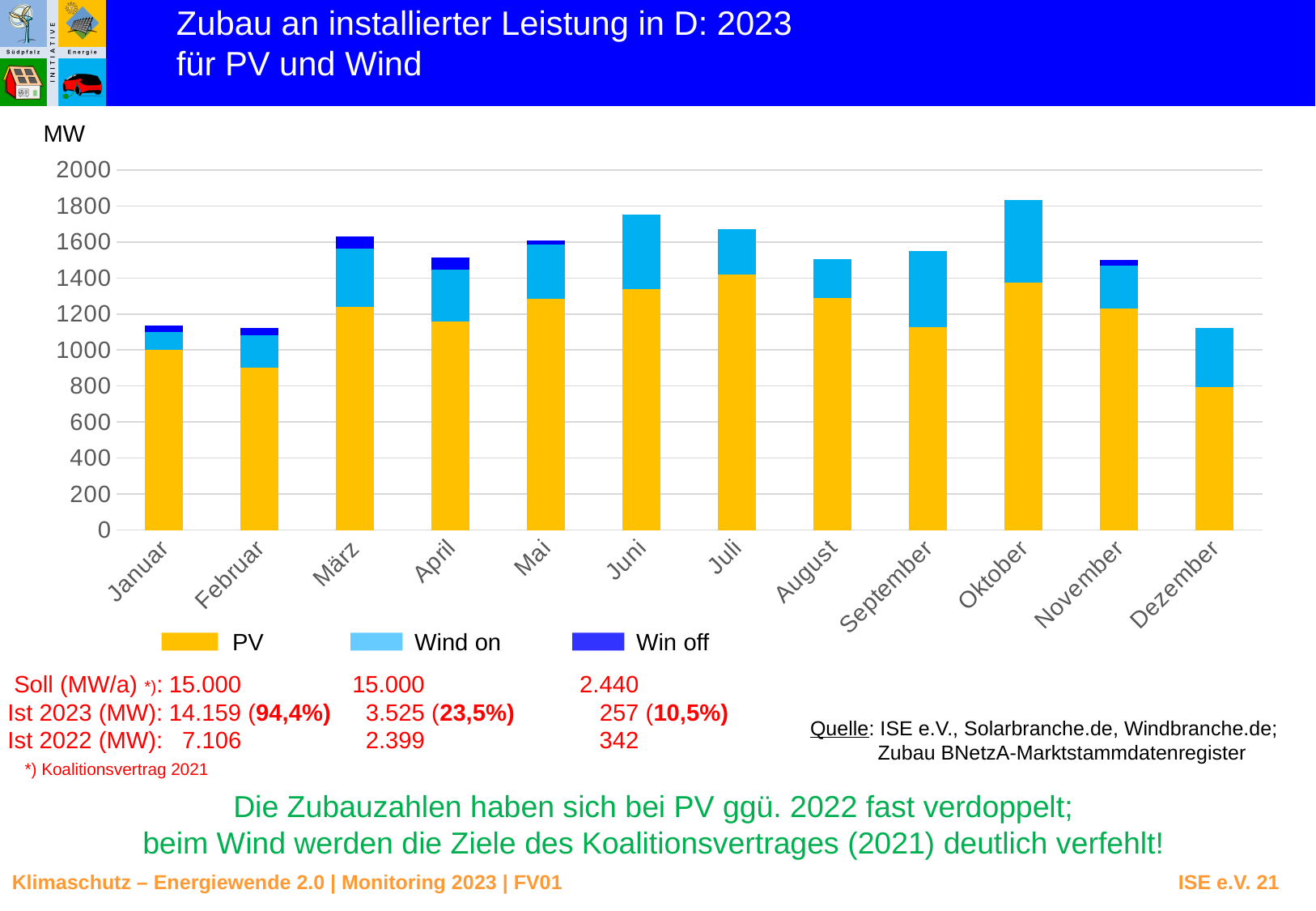
Is the total value for Juni greater or less than 1600? greater How many months (categories) are shown on the x axis of the chart? 12 What kind of chart is shown on the slide? stacked bar chart What are the three series names listed in the chart legend? PV, Wind on, Win off Is the PV value for Dezember greater or less than 1000? less How many series does the chart legend list? 3 Which month has the larger total stacked bar, Oktober or Dezember? Oktober Which month has the larger PV value, Juli or März? Juli Is the PV value for Februar greater or less than 1000? less What unit is shown on the y axis of the chart? MW Which month has the highest total stacked bar in the chart? Oktober